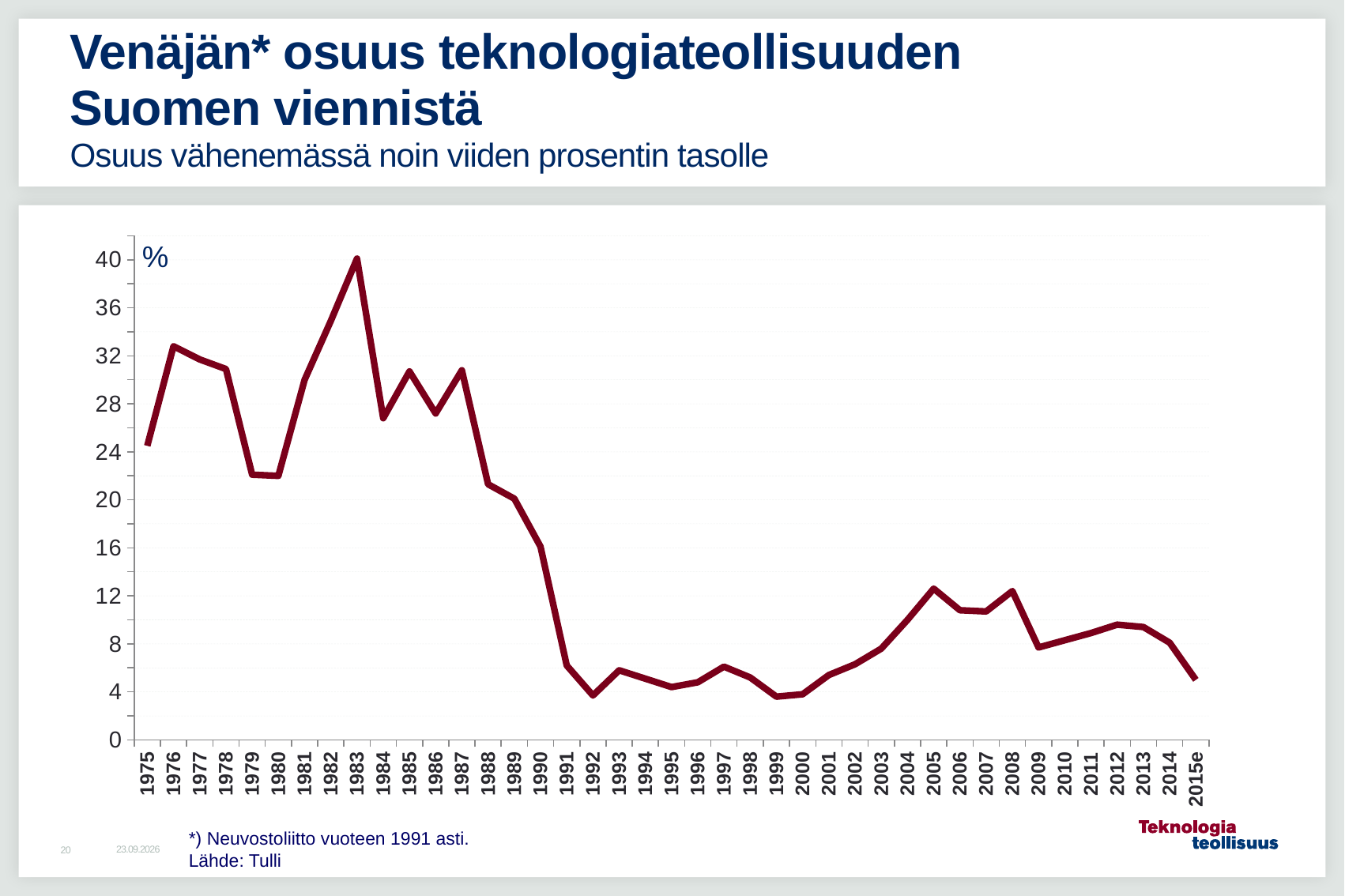
What unit is shown at the top of the y axis? % Which is larger, the value for 2008 or the value for 2009? 2008 Is the value for 2015e greater or less than 8? less Is the value for 1991 greater or less than 8? less Is the value for 1983 greater or less than 36? greater Which year has the highest value on the chart? 1983 What kind of chart is shown on the slide? line chart Which is larger, the value for 1985 or the value for 1984? 1985 How many years (data points) are plotted on the x axis? 41 Do the values rise or fall from 1983 to 1992? fall